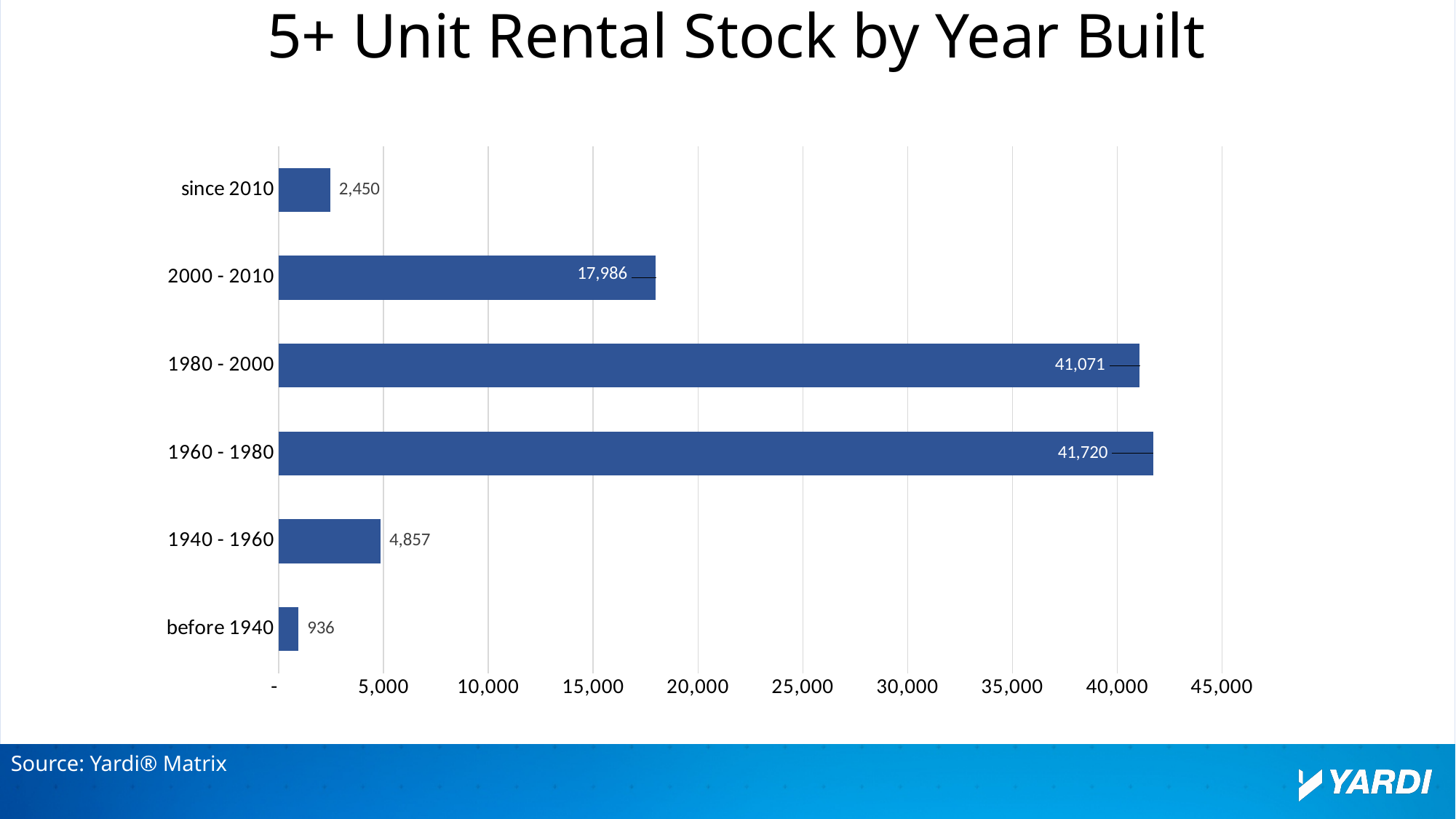
Is the value for 2000 - 2010 greater or less than 15,000? greater Which category has the lowest value? before 1940 Which category has the highest value? 1960 - 1980 What is the value for the 1960 - 1980 category? 41,720 What is the difference between the values for 1940 - 1960 and before 1940? 3,921 What is the value for the since 2010 category? 2,450 What is the value for the before 1940 category? 936 Which is larger, the value for 2000 - 2010 or the value for 1940 - 1960? 2000 - 2010 How many categories are shown in the chart? 6 What kind of chart is shown on the slide? bar chart What is the value for the 2000 - 2010 category? 17,986 What is the difference between the values for 1960 - 1980 and 1980 - 2000? 649